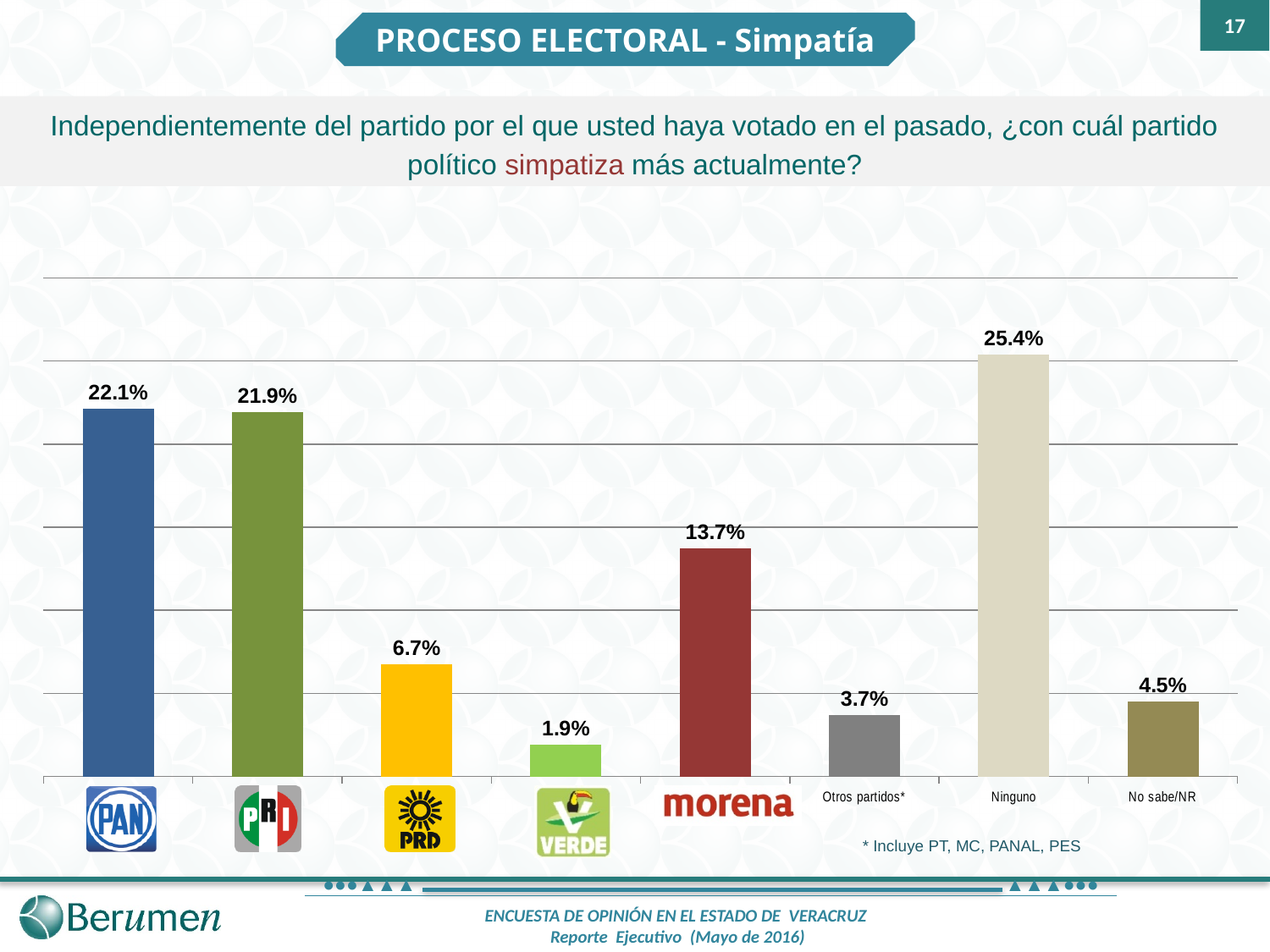
How many categories are shown in the chart? 8 What is the difference between the values for PRD and 'Otros partidos*'? 3.0% What is the difference between the values for PAN and PRI? 0.2% What percentage is shown for 'Ninguno'? 25.4% What kind of chart is shown on the slide? Bar chart What value is shown for 'No sabe/NR'? 4.5% What percentage of respondents said they sympathize most with PAN? 22.1% Which party has the lowest value in the chart? Verde Which category has the highest value in the chart? Ninguno What value is shown for Morena? 13.7% Which is larger, the value for Morena or the value for PRD? Morena According to the footnote, which parties are included in 'Otros partidos*'? PT, MC, PANAL, PES